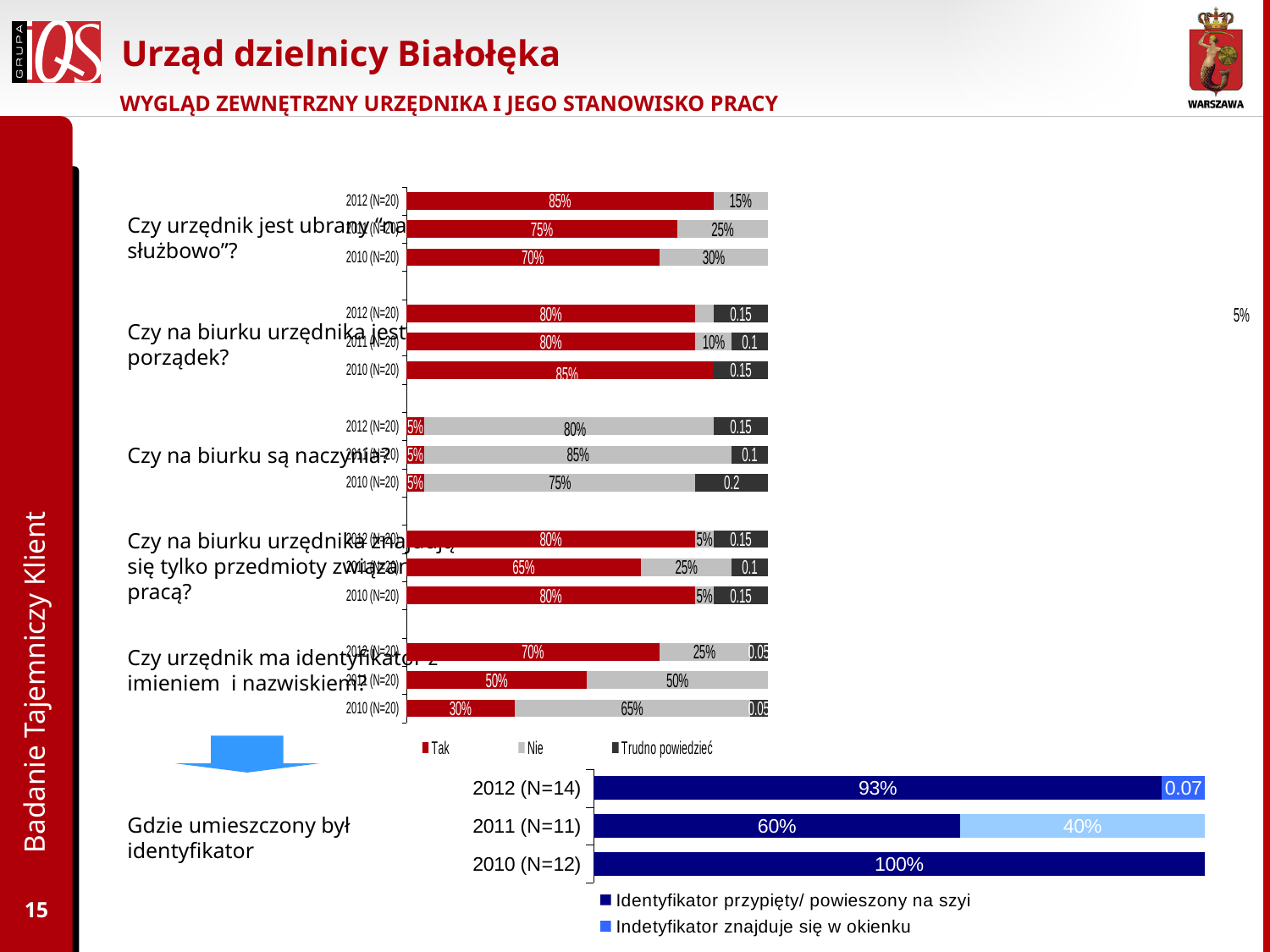
In the upper chart, what is the 'Tak' value for 2012 (N=20) for the question 'Czy urzędnik jest ubrany "na służbowo"?' 85% In the upper chart, for the question 'Czy urzędnik ma identyfikator z imieniem i nazwiskiem?', which year has the highest 'Tak' value? 2012 (N=20) In the lower chart 'Gdzie umieszczony był identyfikator', what is the value for 'Identyfikator przypięty/ powieszony na szyi' in 2011 (N=11)? 60% In the upper chart, what is the 'Tak' value for 2011 (N=20) for the question 'Czy urzędnik ma identyfikator z imieniem i nazwiskiem?' 50% In the upper chart, what is the 'Nie' value for 2010 (N=20) for the question 'Czy urzędnik jest ubrany "na służbowo"?' 30% How many series does the legend of the upper chart list? 3 In the upper chart, does the 'Tak' value for 'Czy urzędnik ma identyfikator z imieniem i nazwiskiem?' rise or fall from 2010 to 2012? rise In the upper chart, for the question 'Czy urzędnik jest ubrany "na służbowo"?', what is the difference between the 'Tak' values for 2012 and 2010? 15% What type of chart is the lower chart 'Gdzie umieszczony był identyfikator'? stacked bar chart In the lower chart 'Gdzie umieszczony był identyfikator', which year has the highest value for 'Identyfikator przypięty/ powieszony na szyi'? 2010 (N=12) In the upper chart, for the question 'Czy na biurku są naczynia?', is the 'Nie' value for 2011 (N=20) larger or smaller than for 2010 (N=20)? larger